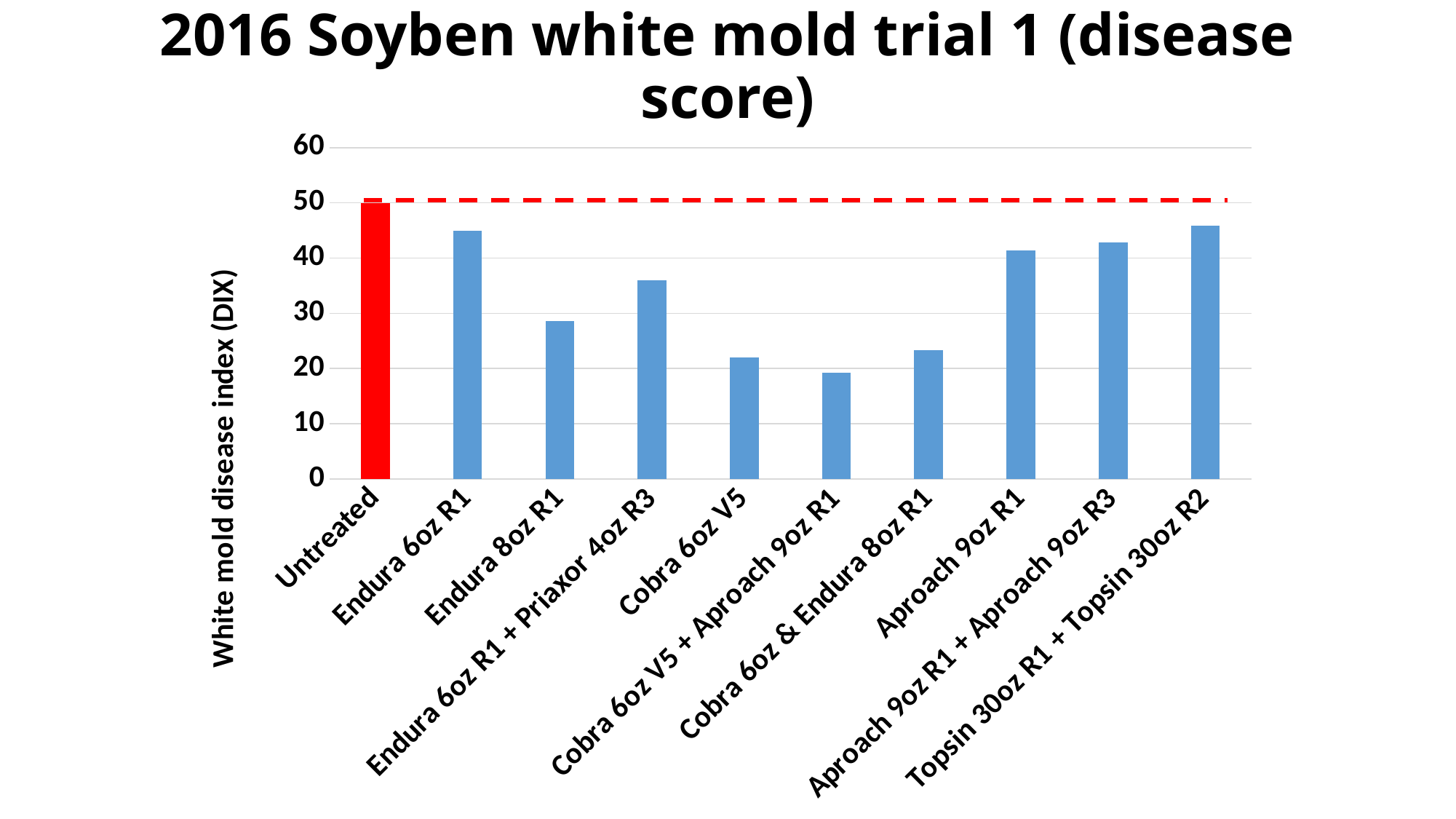
What is the label on the vertical axis of the chart? White mold disease index (DIX) Is the value for Endura 8oz R1 greater or less than 30? less Which bar on the chart is coloured red? Untreated What is the white mold disease index for the Untreated bar? 50 What kind of chart is shown on the slide? bar chart Is the value for Aproach 9oz R1 greater or less than 40? greater Which treatment has the highest white mold disease index? Untreated How many treatment categories are plotted on the chart? 10 Which has a higher disease index, Endura 6oz R1 or Endura 8oz R1? Endura 6oz R1 Which treatment has the lowest white mold disease index? Cobra 6oz V5 + Aproach 9oz R1 Is the value for Endura 6oz R1 + Priaxor 4oz R3 greater or less than 40? less Which has a higher disease index, Topsin 30oz R1 + Topsin 30oz R2 or Aproach 9oz R1? Topsin 30oz R1 + Topsin 30oz R2